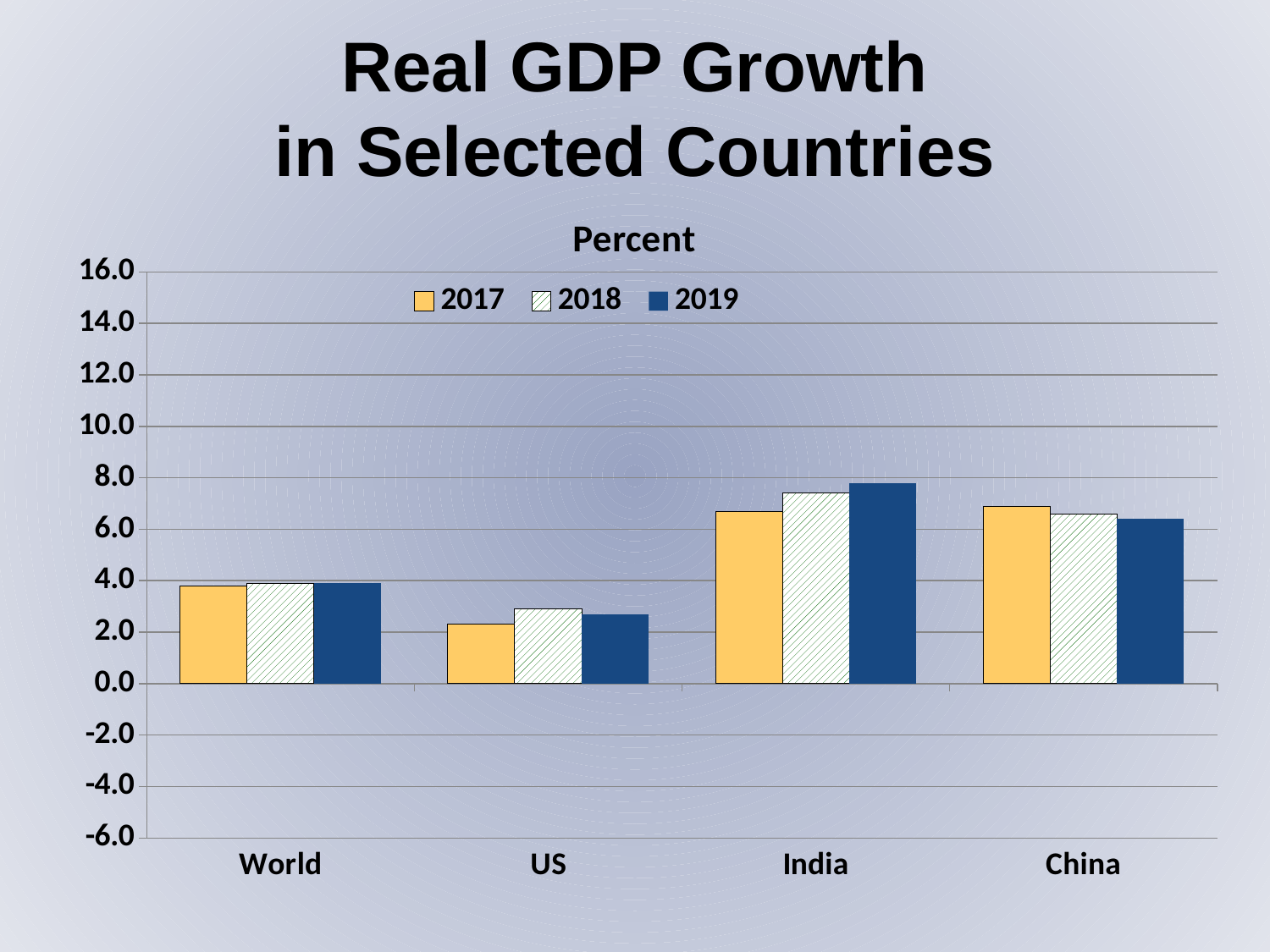
What kind of chart is shown on the slide? bar chart Which is larger, the 2019 value for India or the 2019 value for China? India Which country or region has the highest real GDP growth for 2019? India Do China's values rise or fall from 2017 to 2019? fall How many countries or regions are shown on the x axis? 4 Which country or region has the lowest real GDP growth for 2017? US Is the 2017 value for the US greater or less than 4.0? less What unit label is shown above the chart's legend? Percent For the US, which is larger, the 2017 value or the 2018 value? 2018 Is the 2017 value for China greater or less than 8.0? less Is the 2019 value for India greater or less than 6.0? greater How many series does the legend list? 3